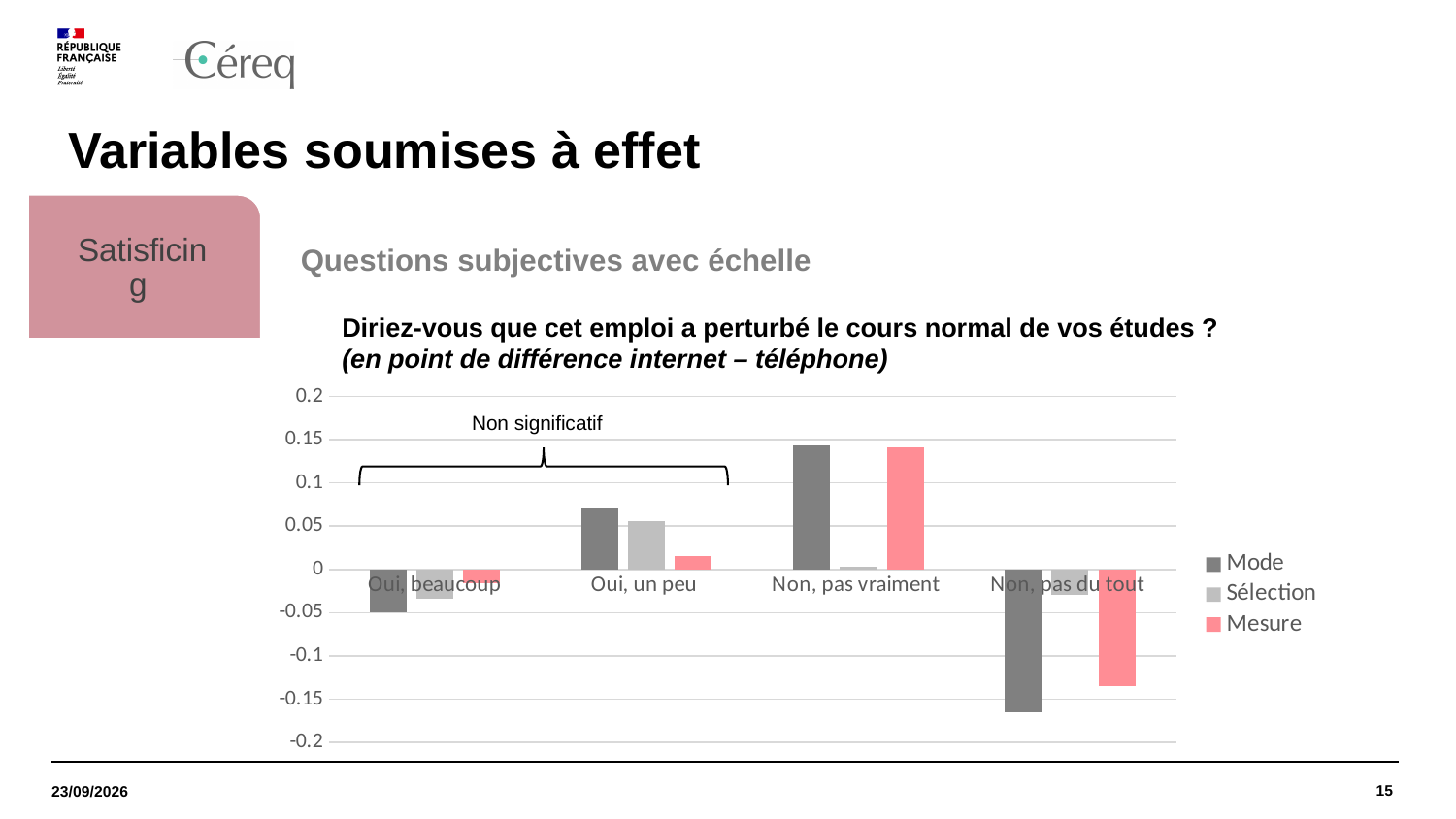
How many series does the chart legend list? 3 Is the Mode value for 'Non, pas vraiment' greater or less than 0.1? greater Is the Mode value for 'Oui, un peu' greater or less than 0.05? greater How many categories are shown on the x axis of the chart? 4 What kind of chart is shown on the slide? bar chart Is the Mesure value for 'Oui, un peu' greater or less than 0.05? less Which is larger for 'Non, pas vraiment': the Mode value or the Sélection value? Mode For which category is the Mode value the lowest? Non, pas du tout Which categories does the 'Non significatif' bracket above the chart cover? Oui, beaucoup and Oui, un peu Which series are listed in the chart legend? Mode, Sélection, Mesure